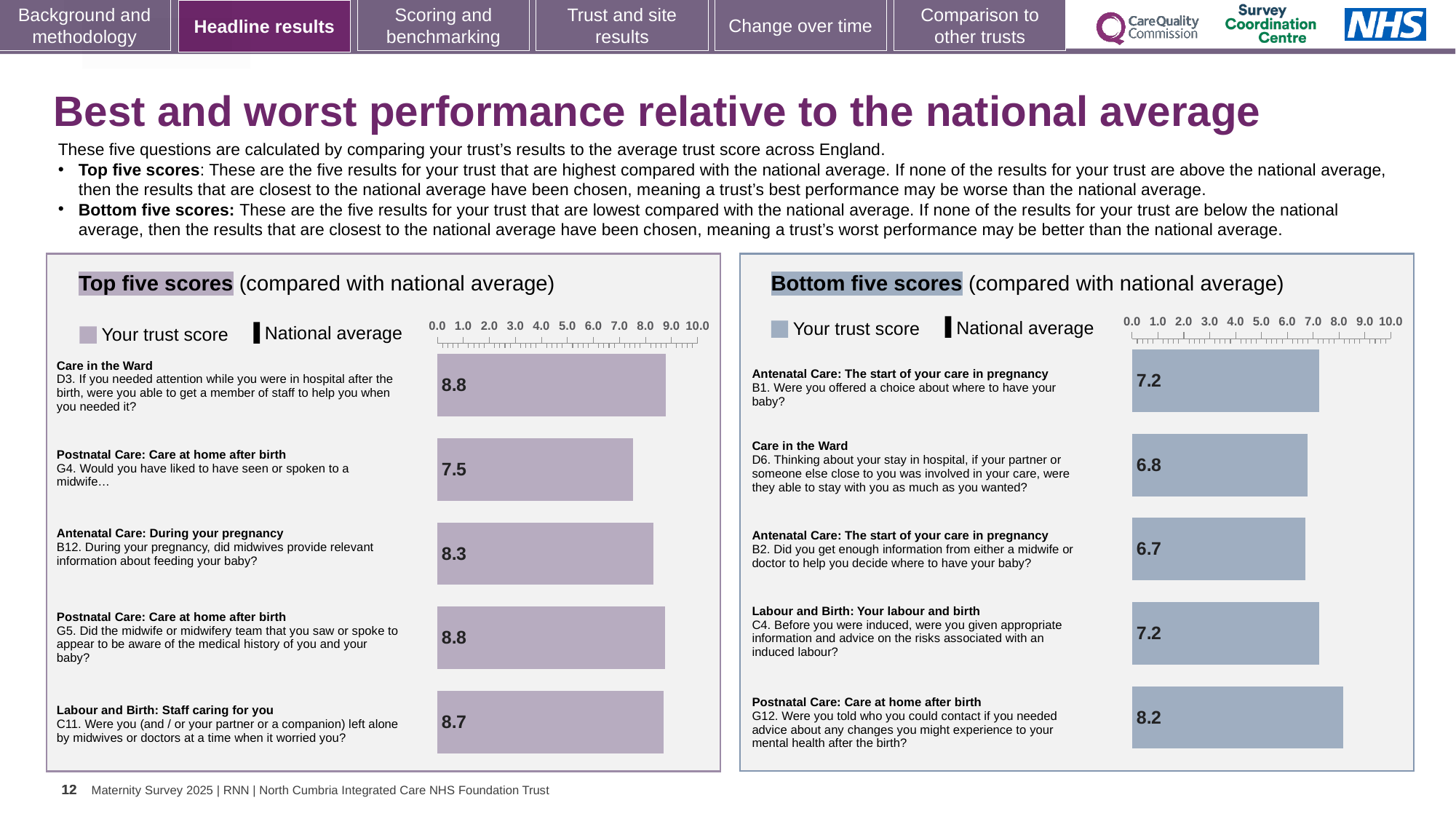
In the Bottom five scores chart, what is the difference between the trust scores for G12 and B2? 1.5 What kind of chart is the Top five scores chart? Bar chart In the Bottom five scores chart, is the trust score for B1 greater or less than 8.0? less In the Bottom five scores chart, what is the trust score for question G12 (Postnatal Care: Care at home after birth)? 8.2 In the Top five scores chart, which has the larger trust score, B12 or C11? C11 In the Top five scores chart, what is the difference between the trust scores for D3 and G4? 1.3 In the Top five scores chart, what is the trust score for question D3 (Care in the Ward)? 8.8 How many questions are plotted in the Bottom five scores chart? 5 In the Top five scores chart, what is the trust score for question G4 (Postnatal Care: Care at home after birth)? 7.5 In the Bottom five scores chart, which question has the highest trust score? G12 In the Bottom five scores chart, what is the trust score for question D6 (Care in the Ward)? 6.8 In the Top five scores chart, which question has the lowest trust score? G4